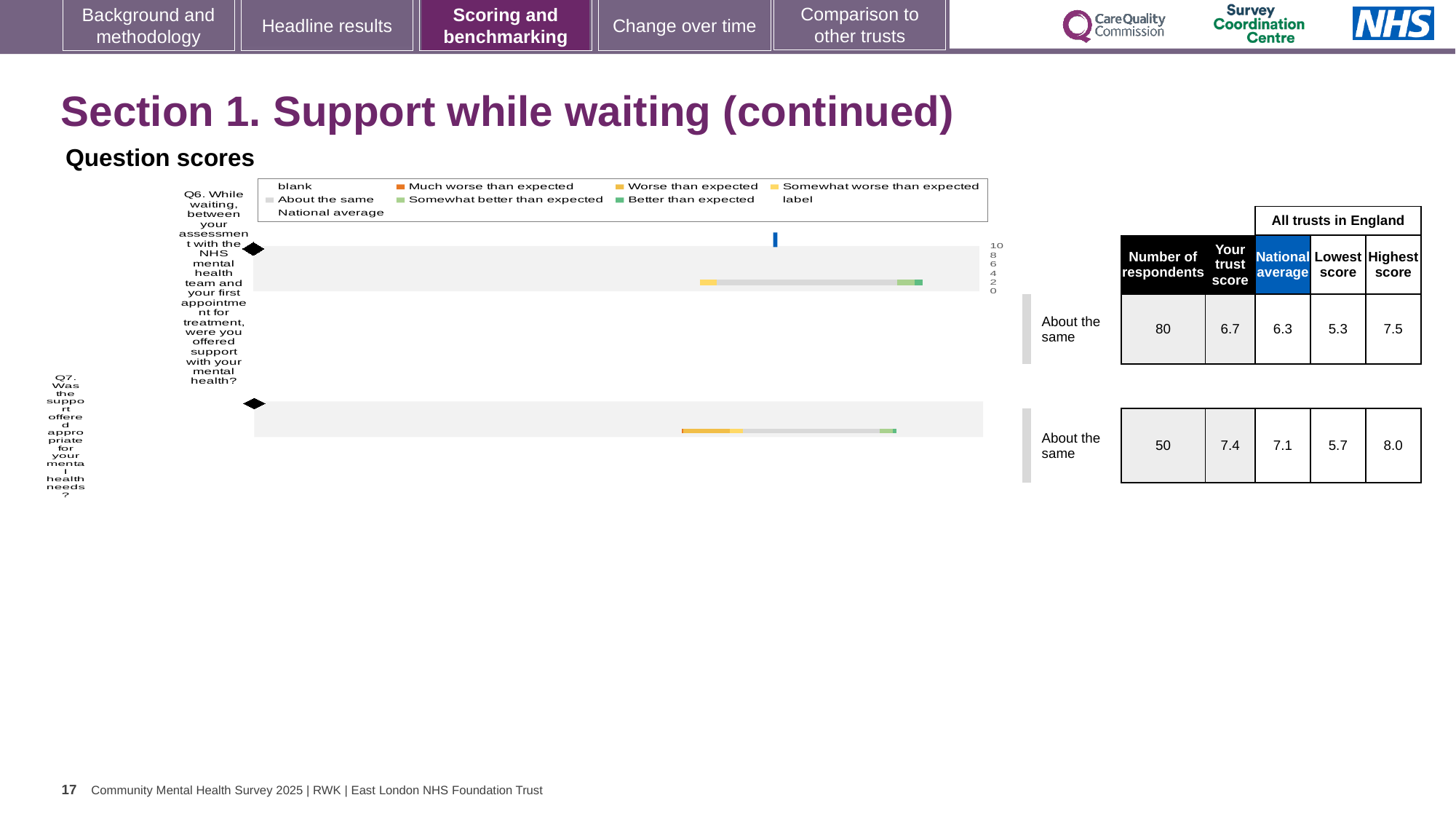
How many questions (Q6 and Q7) are plotted on the slide? 2 For Q6, what is the 'Your trust score' value? 6.7 For Q6, which is larger: the trust score or the national average? the trust score For Q7, what is the 'Your trust score' value? 7.4 What benchmark category is shown next to the Q7 chart? About the same For Q7, what is the difference between the highest score and the lowest score? 2.3 For Q6, what is the national average score? 6.3 For Q6, how many respondents are shown in the table? 80 For Q6, what is the difference between the trust score and the national average? 0.4 What kind of chart is used to show the question scores on this slide? bar chart For Q7, what is the lowest score among all trusts in England? 5.7 For Q7, what is the highest score among all trusts in England? 8.0